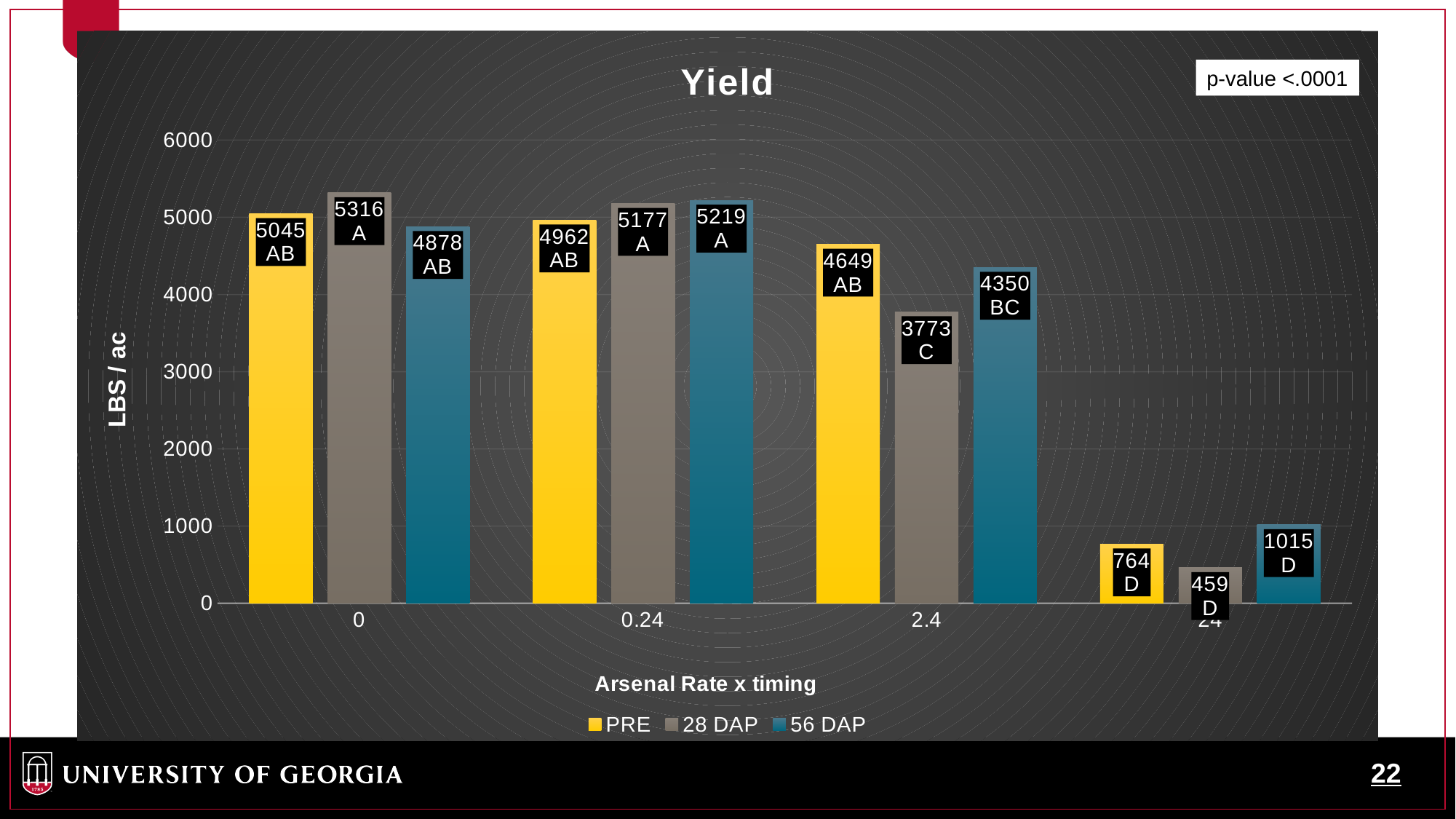
Is the 56 DAP yield at Arsenal rate 2.4 greater or less than 4000? greater How many series does the legend list? 3 What is the difference between the 28 DAP and PRE yields at Arsenal rate 0? 271 Which series has the lowest yield at Arsenal rate 24? 28 DAP What kind of chart is shown on the slide? bar chart What is the y-axis label of the chart? LBS / ac What is the yield for the 28 DAP series at Arsenal rate 0? 5316 Which series has the highest yield at Arsenal rate 2.4? PRE What is the yield for the 56 DAP series at Arsenal rate 0.24? 5219 Which is larger at Arsenal rate 0.24: the PRE yield or the 28 DAP yield? 28 DAP How many Arsenal rate categories are shown on the x axis? 4 What is the yield for the PRE series at Arsenal rate 2.4? 4649